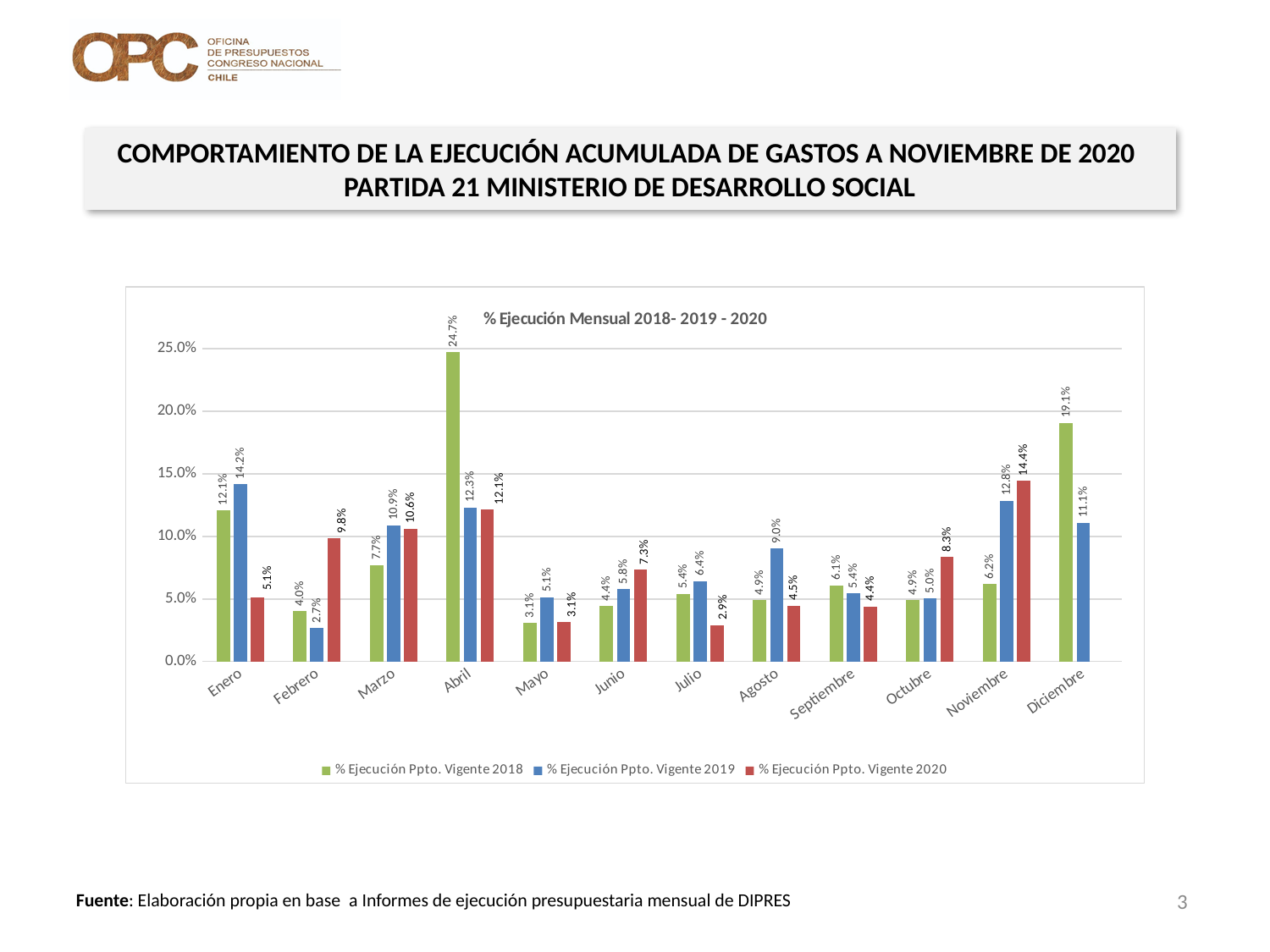
Which month has the highest value for % Ejecución Ppto. Vigente 2018? Abril What is the value for % Ejecución Ppto. Vigente 2019 in Agosto? 9.0% Which is larger in Febrero: the 2020 value or the 2018 value? 2020 What is the difference between the 2019 and 2018 values in Enero? 2.1% What is the value for % Ejecución Ppto. Vigente 2020 in Noviembre? 14.4% What kind of chart is shown? Bar chart Which month has the lowest value for % Ejecución Ppto. Vigente 2019? Febrero What is the value for % Ejecución Ppto. Vigente 2018 in Abril? 24.7% Is the value for % Ejecución Ppto. Vigente 2018 in Diciembre greater or less than 15.0%? greater How many months are shown on the x axis? 12 What is the title of the chart? % Ejecución Mensual 2018- 2019 - 2020 How many series does the legend list? 3